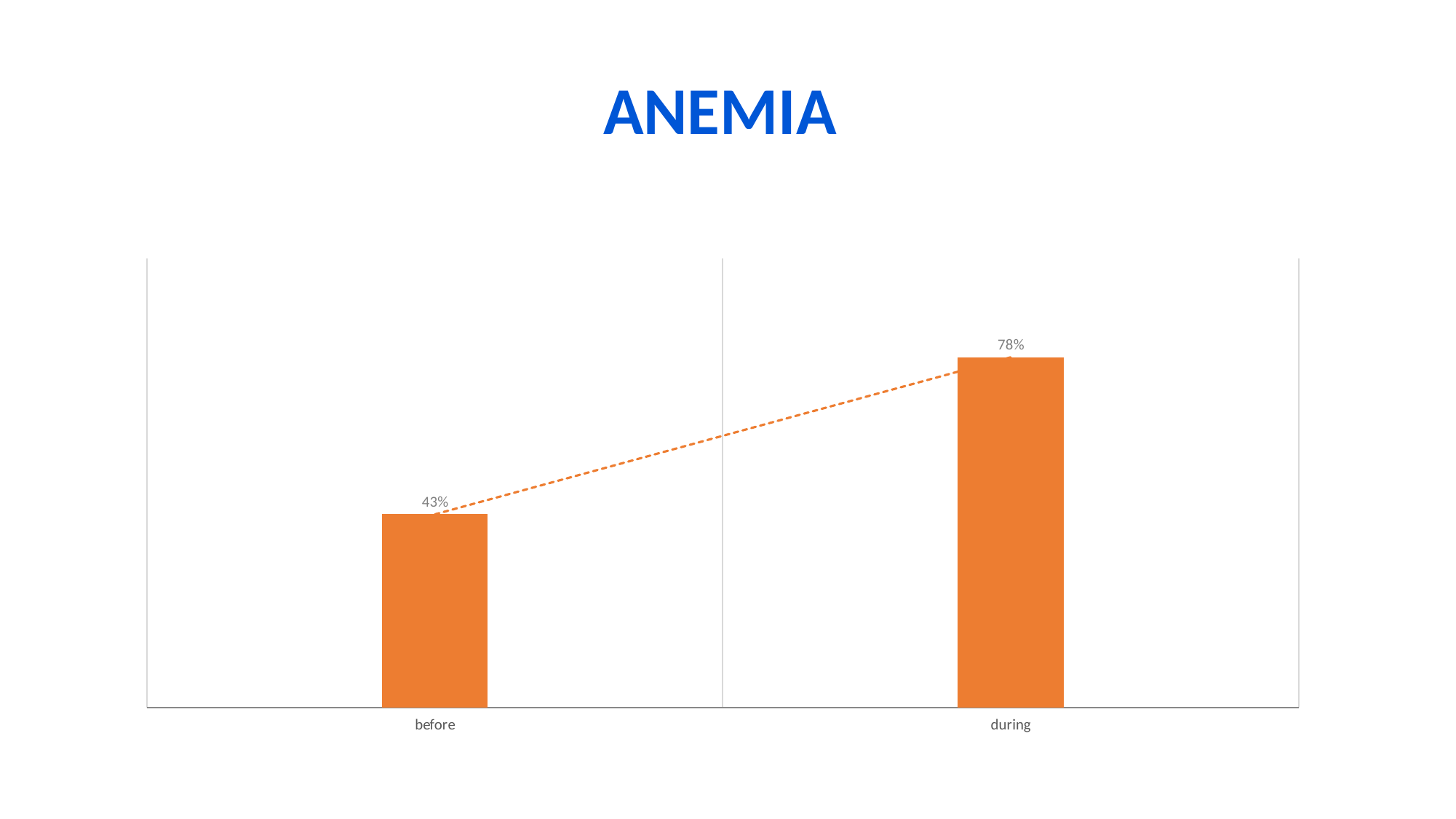
How many categories are shown on the x axis? 2 What is the title of the slide? ANEMIA What is the value for "during"? 78% What is the difference between the values for "during" and "before"? 35% What colour are the bars in the chart? orange What kind of chart is shown on the slide? bar chart Which category has the lowest value? before Which category has the highest value? during Do the values rise or fall from "before" to "during"? rise Which is larger, the value for "before" or the value for "during"? during What is the value for "before"? 43%